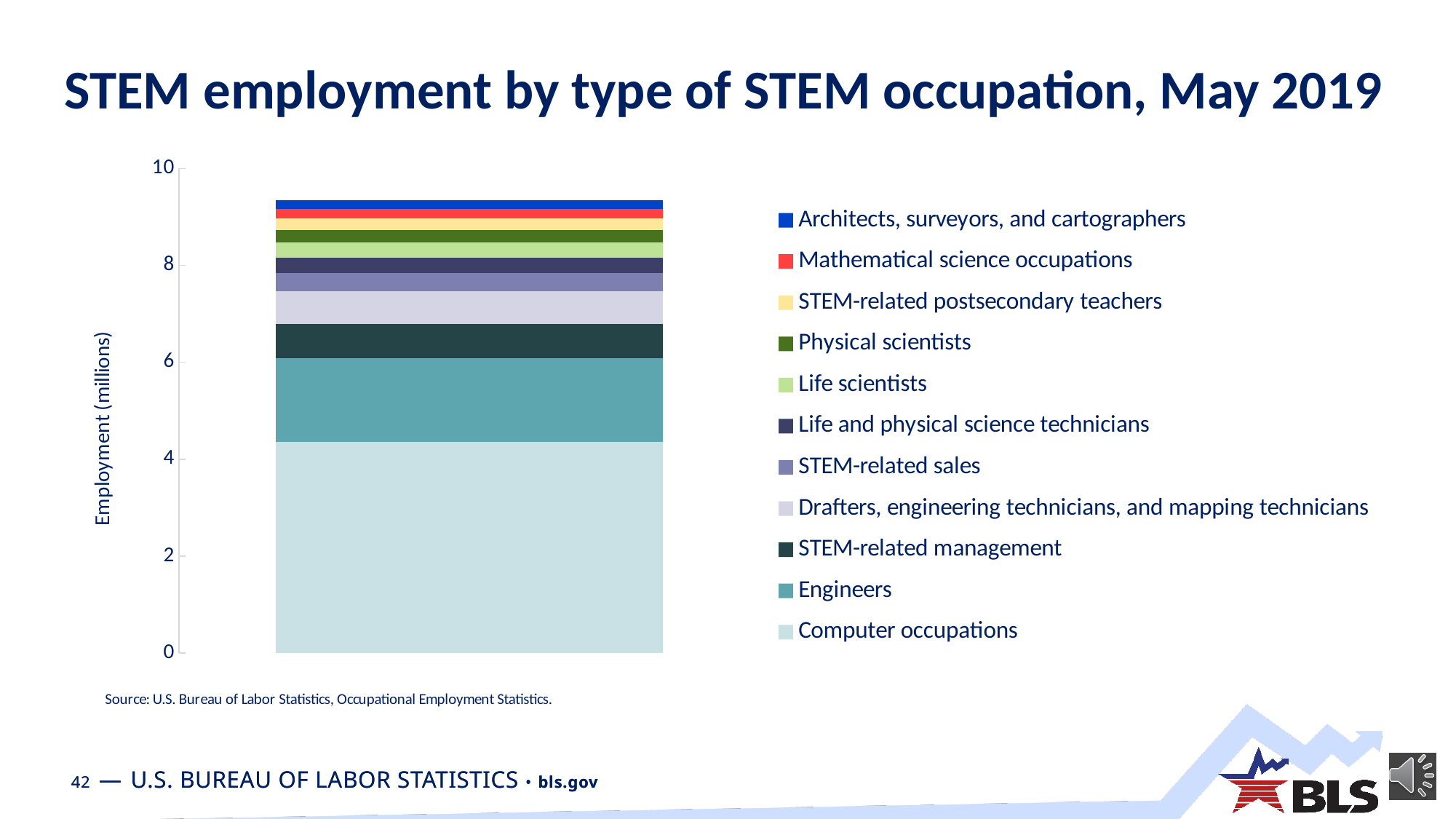
Which segment is larger, Engineers or STEM-related management? Engineers What is the title of the chart? STEM employment by type of STEM occupation, May 2019 Is the employment for Computer occupations greater or less than 4 million? greater Is the total height of the stacked bar greater or less than 8 million? greater What is the label on the vertical axis? Employment (millions) How many bars are plotted in the chart? 1 Which STEM occupation type has the largest segment in the stacked bar? Computer occupations Which segment is larger, Computer occupations or Engineers? Computer occupations Is the total height of the stacked bar greater or less than 10 million? less How many series does the legend list? 11 What kind of chart is shown on the slide? Stacked bar chart